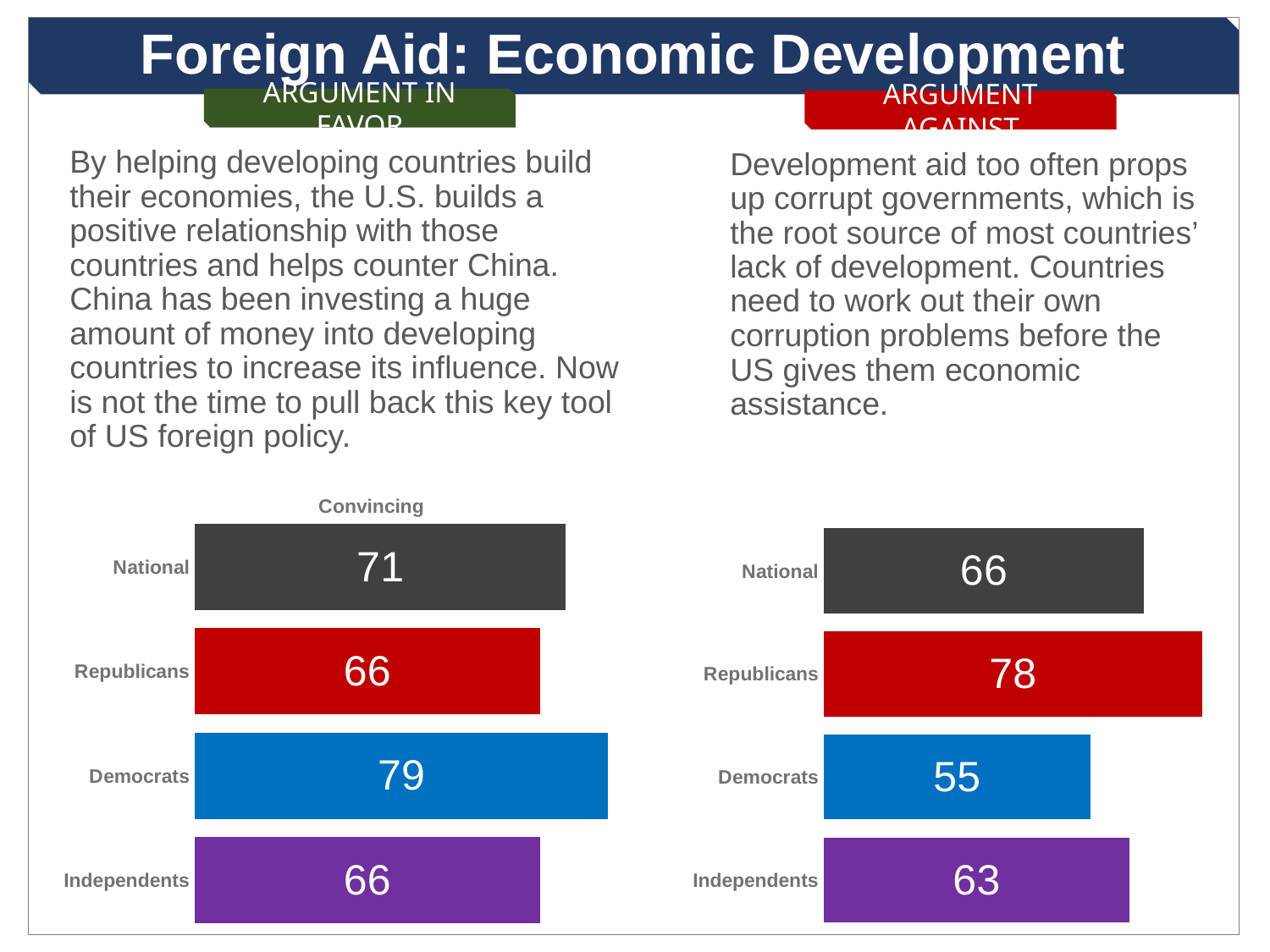
On the left chart, which is larger, the value for National or the value for Republicans? National On the right chart, which category has the lowest value? Democrats How many categories does the right chart show? 4 What kind of chart is the left chart? Bar chart On the left chart, what is the difference between the Democrats value and the National value? 8 On the left chart, what is the value for Democrats? 79 On the left chart, which category has the highest value? Democrats On the left chart, what is the value for National? 71 On the right chart, what is the value for Independents? 63 On the right chart, what is the difference between the Republicans value and the Democrats value? 23 On the right chart, what is the value for Republicans? 78 On the right chart, which category has the highest value? Republicans